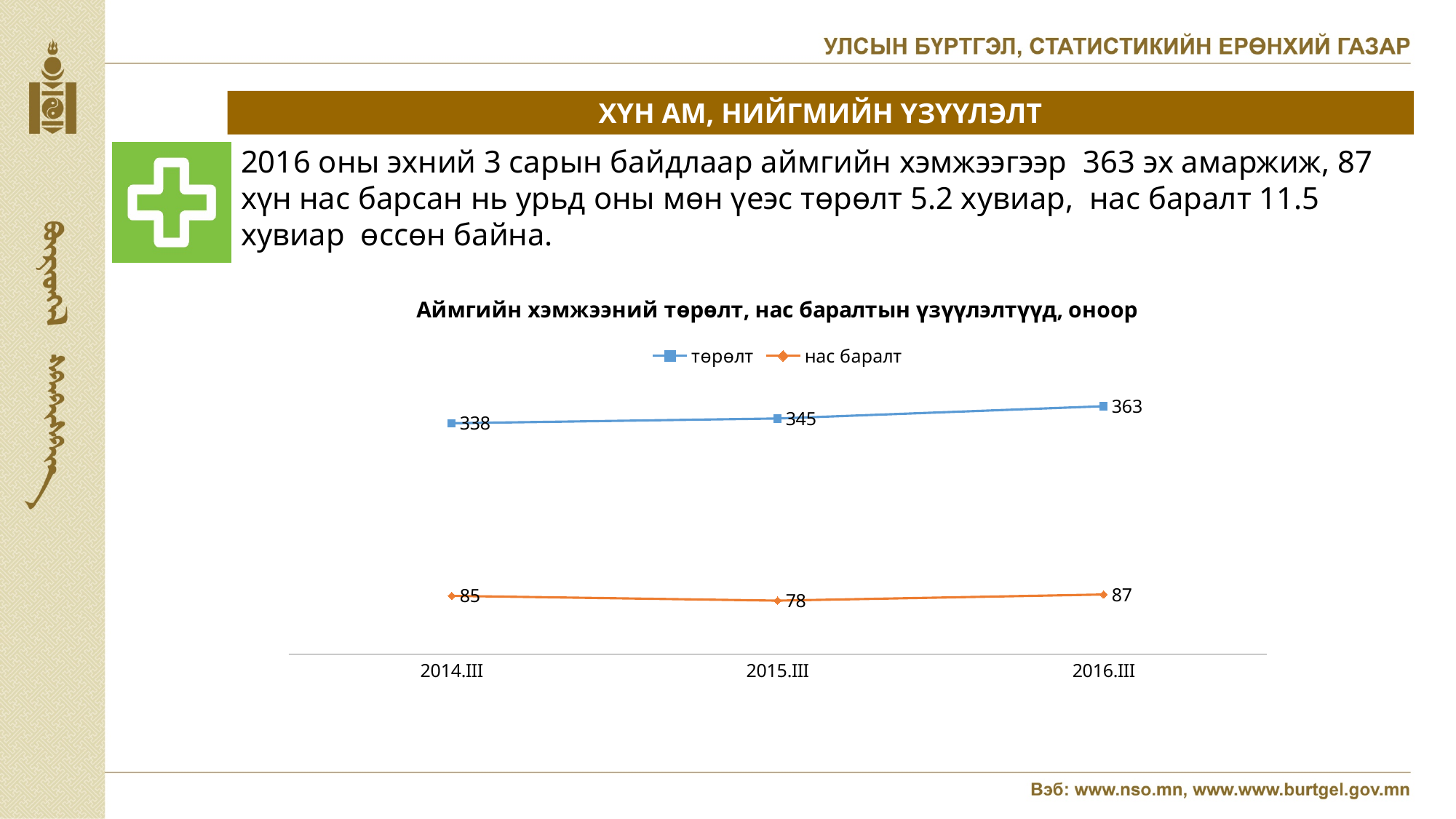
What kind of chart is shown? line chart In which period is нас баралт lowest? 2015.III How many periods are shown on the x axis? 3 Which is larger: нас баралт in 2014.III or in 2016.III? 2016.III What is the value of нас баралт for 2015.III? 78 What is the difference between төрөлт in 2016.III and 2015.III? 18 In which period is төрөлт highest? 2016.III How many series does the legend list? 2 What is the value of төрөлт for 2014.III? 338 What is the difference between нас баралт in 2016.III and 2015.III? 9 What is the value of төрөлт for 2016.III? 363 What is the value of нас баралт for 2014.III? 85